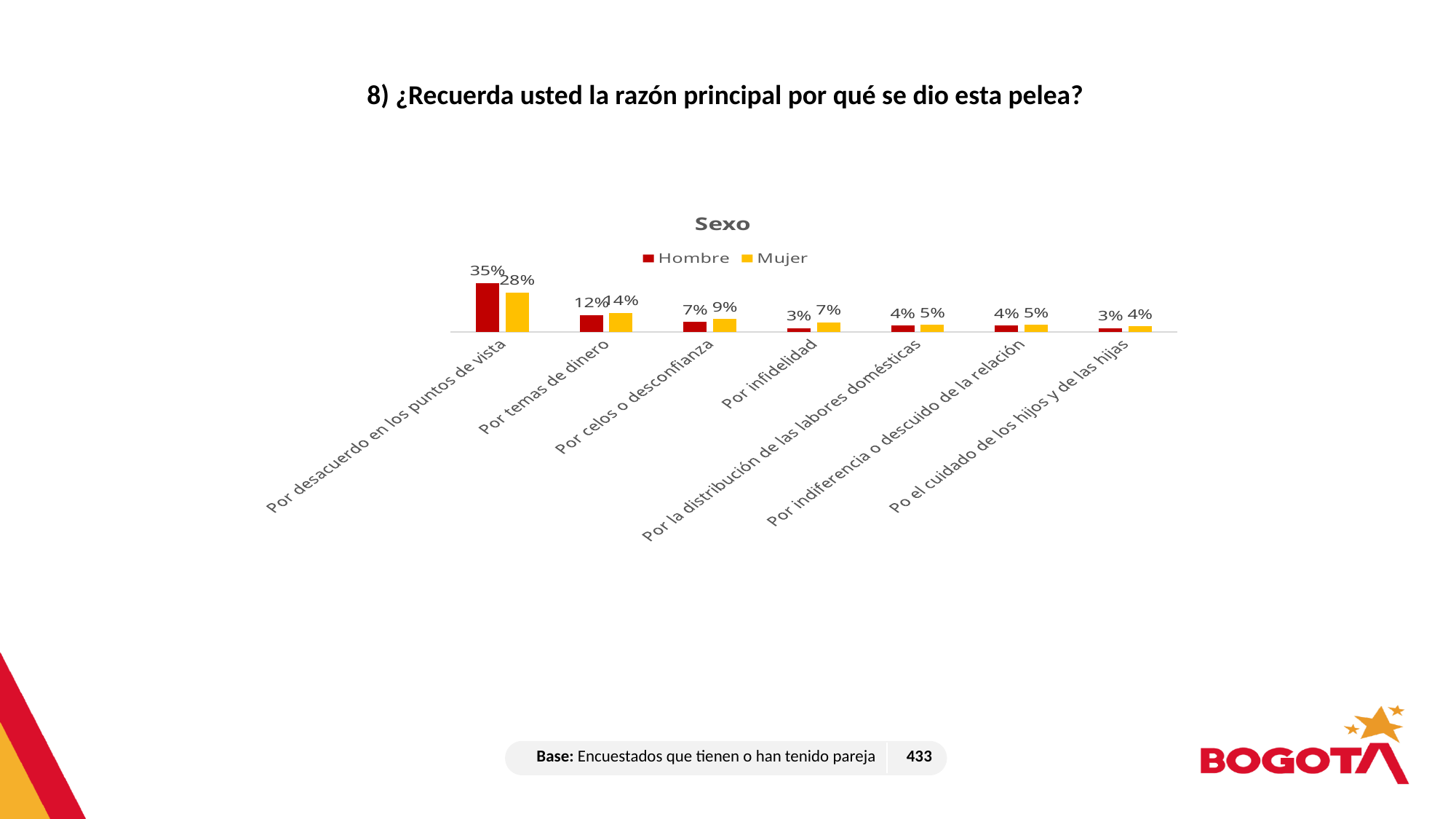
What is the title of the chart? Sexo What is the Hombre value for 'Por desacuerdo en los puntos de vista'? 35% What is the difference between the Hombre and Mujer values for 'Por desacuerdo en los puntos de vista'? 7% What type of chart is shown on the slide? bar chart What is the Hombre value for 'Por celos o desconfianza'? 7% How many categories are shown on the x axis of the chart? 7 Which category has the highest Hombre value? Por desacuerdo en los puntos de vista How many series does the legend of the chart list? 2 For 'Por infidelidad', which is larger, the Hombre value or the Mujer value? Mujer What is the Mujer value for 'Por infidelidad'? 7% What is the Mujer value for 'Por desacuerdo en los puntos de vista'? 28% What is the difference between the Mujer and Hombre values for 'Por infidelidad'? 4%